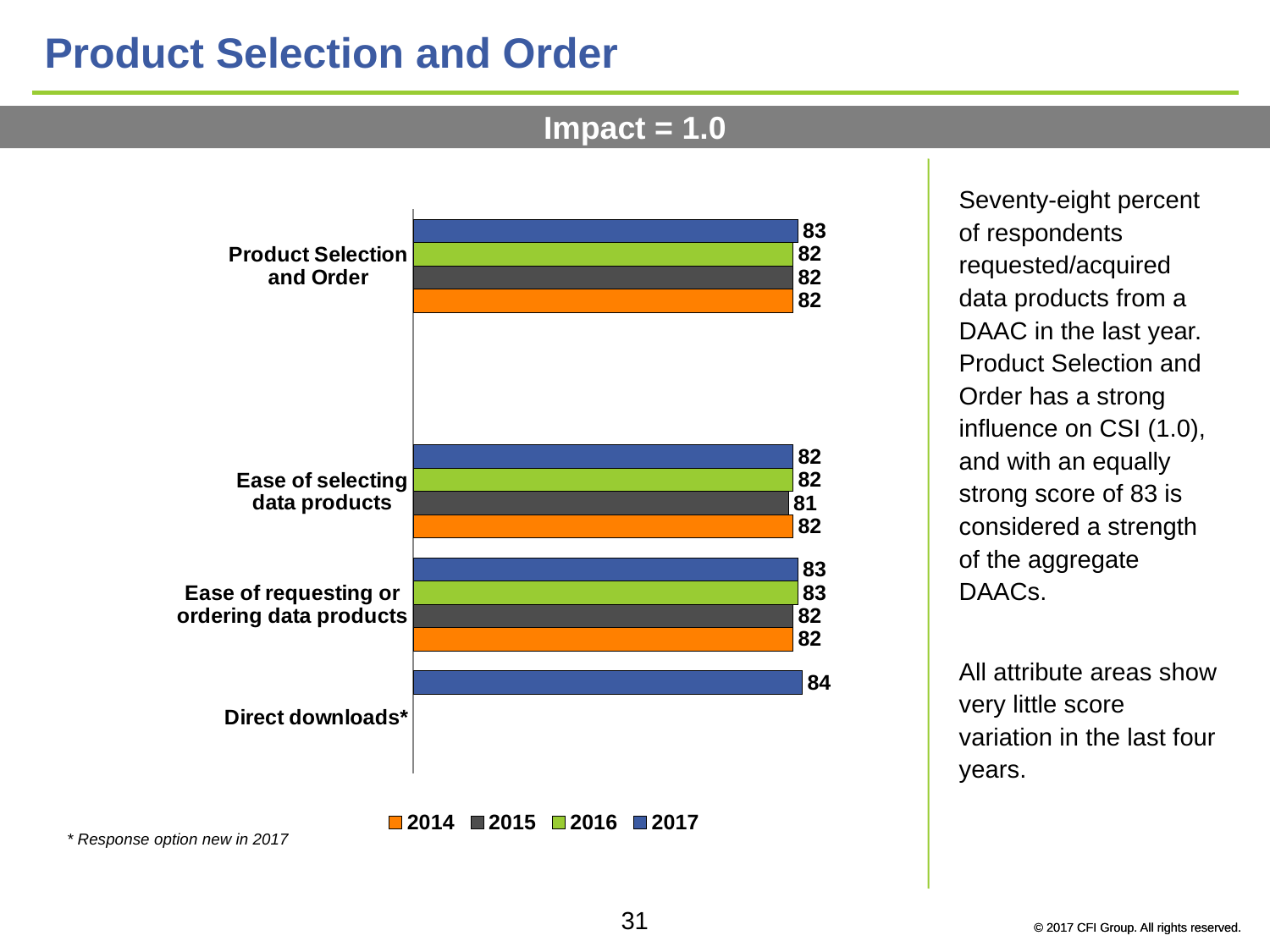
What is the 2017 value for Product Selection and Order? 83 What kind of chart is shown on the slide? Bar chart What is the difference between the 2017 value for Direct downloads* and the 2015 value for Ease of selecting data products? 3 How many categories are shown on the chart? 4 How many series does the legend list? 4 What is the 2015 value for Ease of selecting data products? 81 Which is larger: the 2017 value for Product Selection and Order or the 2017 value for Ease of selecting data products? 2017 value for Product Selection and Order What is the 2014 value for Ease of requesting or ordering data products? 82 Which category has the highest 2017 value? Direct downloads* What is the 2017 value for Direct downloads*? 84 Which category has the lowest 2015 value? Ease of selecting data products Which year is shown in orange in the legend? 2014